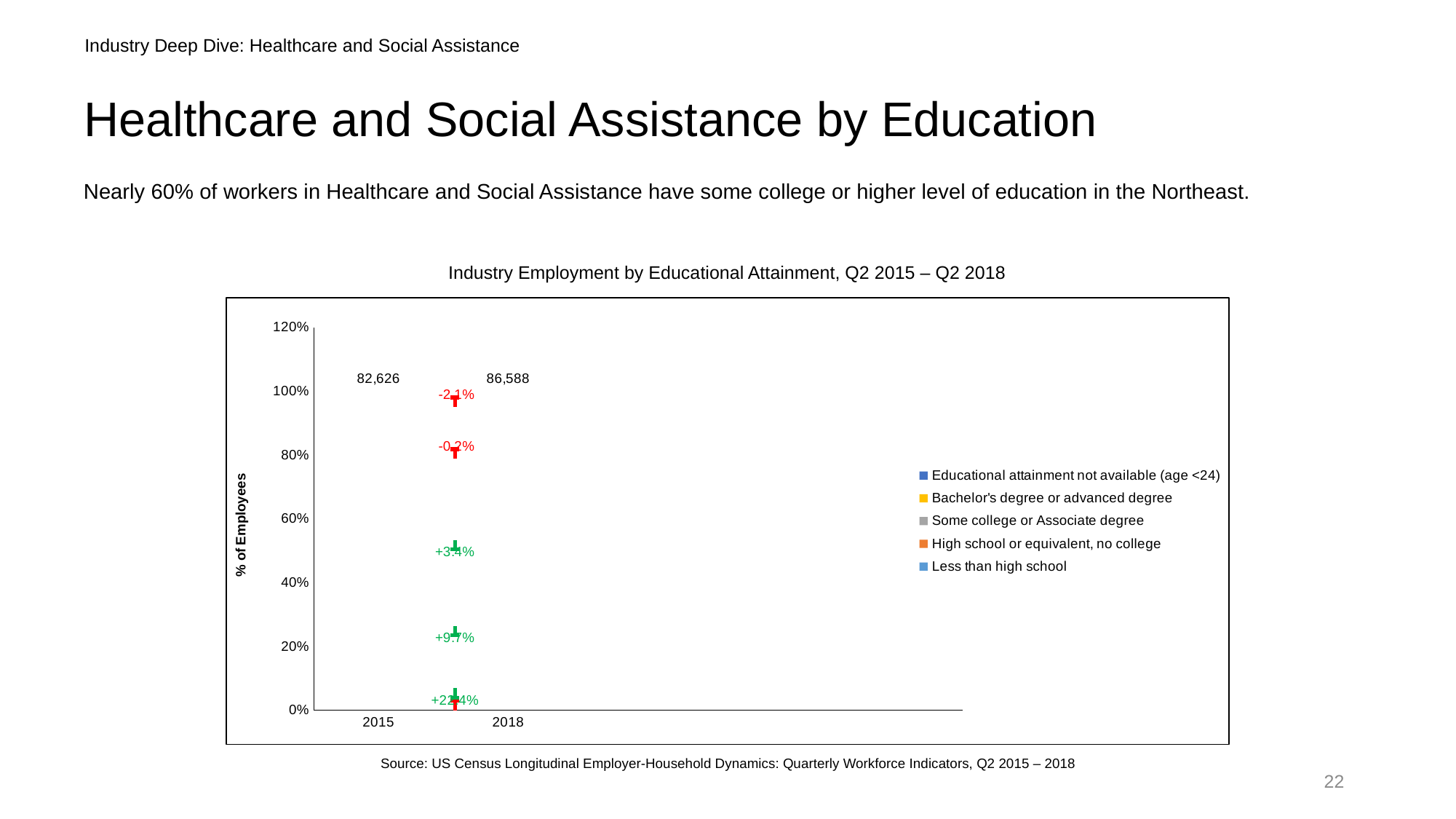
What is the title of the chart? Industry Employment by Educational Attainment, Q2 2015 – Q2 2018 Which year has the larger total employment figure printed above it, 2015 or 2018? 2018 What is the highest value shown on the y axis of the chart? 120% What is the label on the y axis of the chart? % of Employees What total employment figure is printed above the 2015 category? 82,626 How many categories are shown on the x axis of the chart? 2 What total employment figure is printed above the 2018 category? 86,588 How many series does the chart legend list? 5 What is the difference between the total employment figures printed for 2018 and 2015? 3,962 Which legend entry is listed first in the chart? Educational attainment not available (age <24)